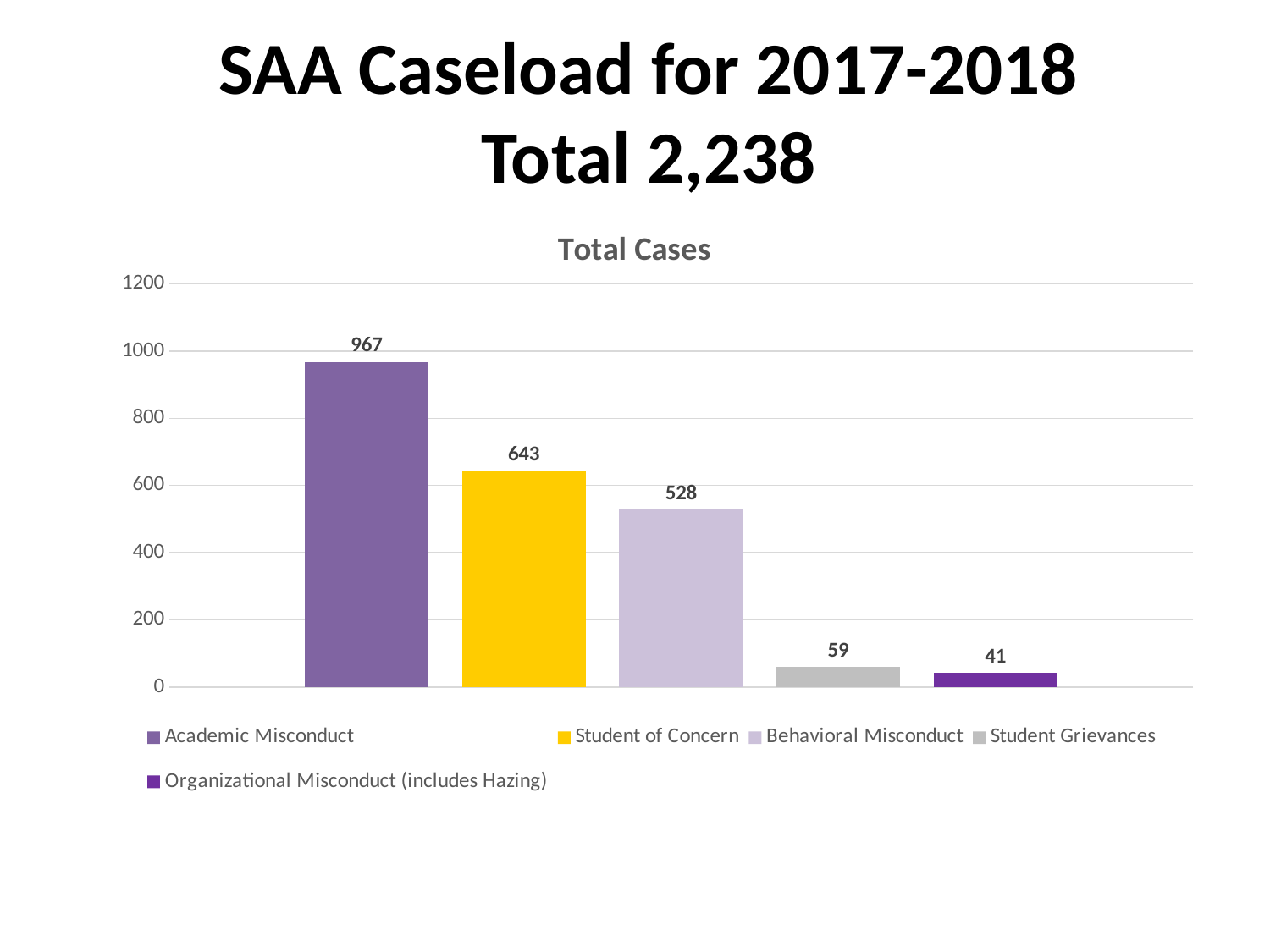
What is the value for Behavioral Misconduct? 528 What is the value for Academic Misconduct? 967 What kind of chart is shown on the slide? Bar chart Which category has the lowest number of cases? Organizational Misconduct (includes Hazing) What is the value for Organizational Misconduct (includes Hazing)? 41 What is the value for Student of Concern? 643 What is the title of the chart? Total Cases Which category has the highest number of cases? Academic Misconduct Which is larger, Student of Concern or Behavioral Misconduct? Student of Concern What is the difference between Academic Misconduct and Student of Concern? 324 What is the difference between Student Grievances and Organizational Misconduct (includes Hazing)? 18 How many categories are shown in the chart? 5